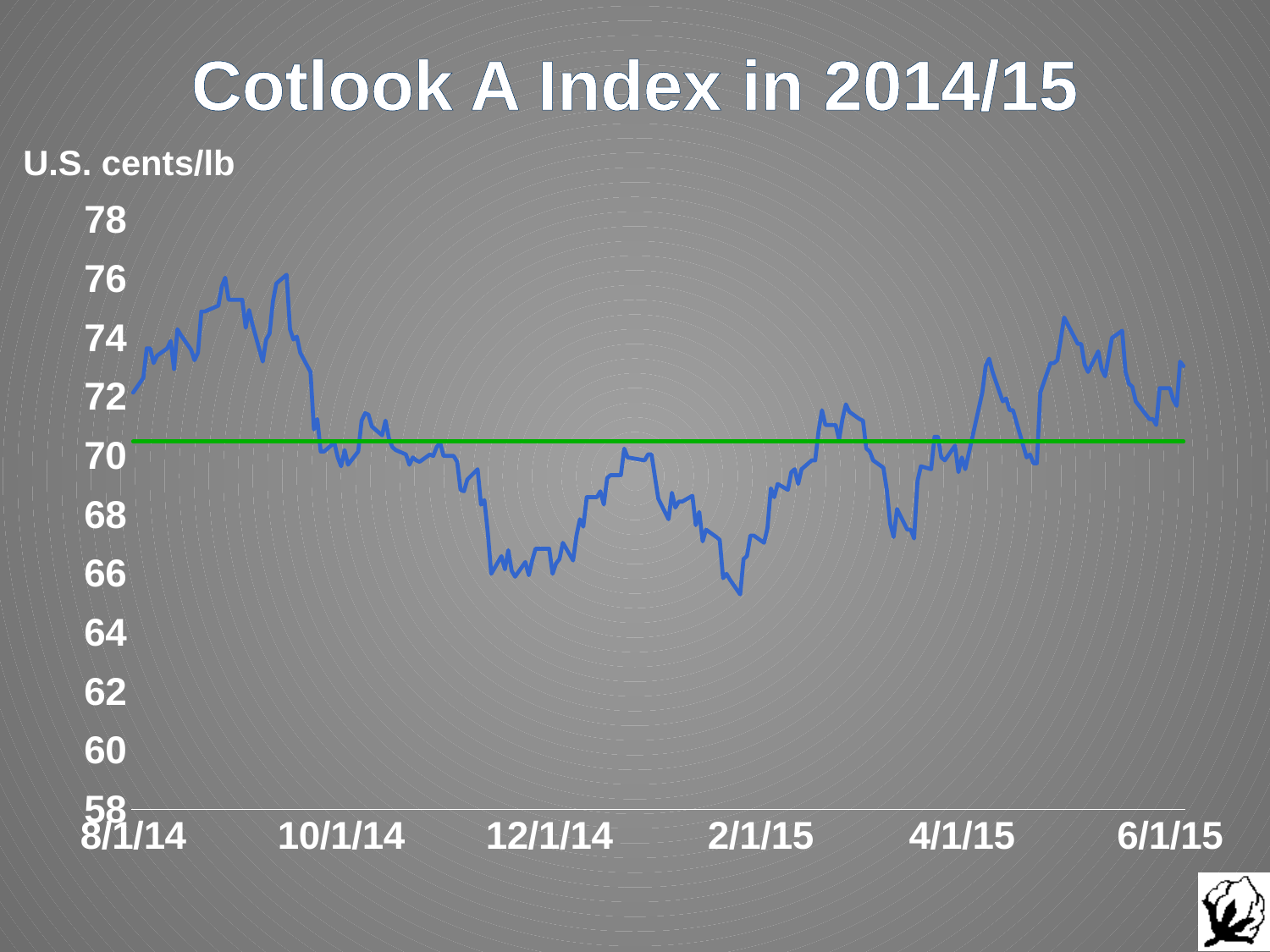
What kind of chart is shown on the slide? line chart Is the value of the Cotlook A Index at 12/1/14 greater or less than 68? less Is the lowest point reached by the index line greater or less than 66? less What is the title of the chart? Cotlook A Index in 2014/15 Is the value of the Cotlook A Index at 6/1/15 greater or less than 70? greater Which date has the higher index value, 8/1/14 or 2/1/15? 8/1/14 In what unit are the values on the y axis expressed? U.S. cents/lb How many date labels are shown on the x axis? 6 Does the index generally rise or fall between 8/1/14 and 12/1/14? fall